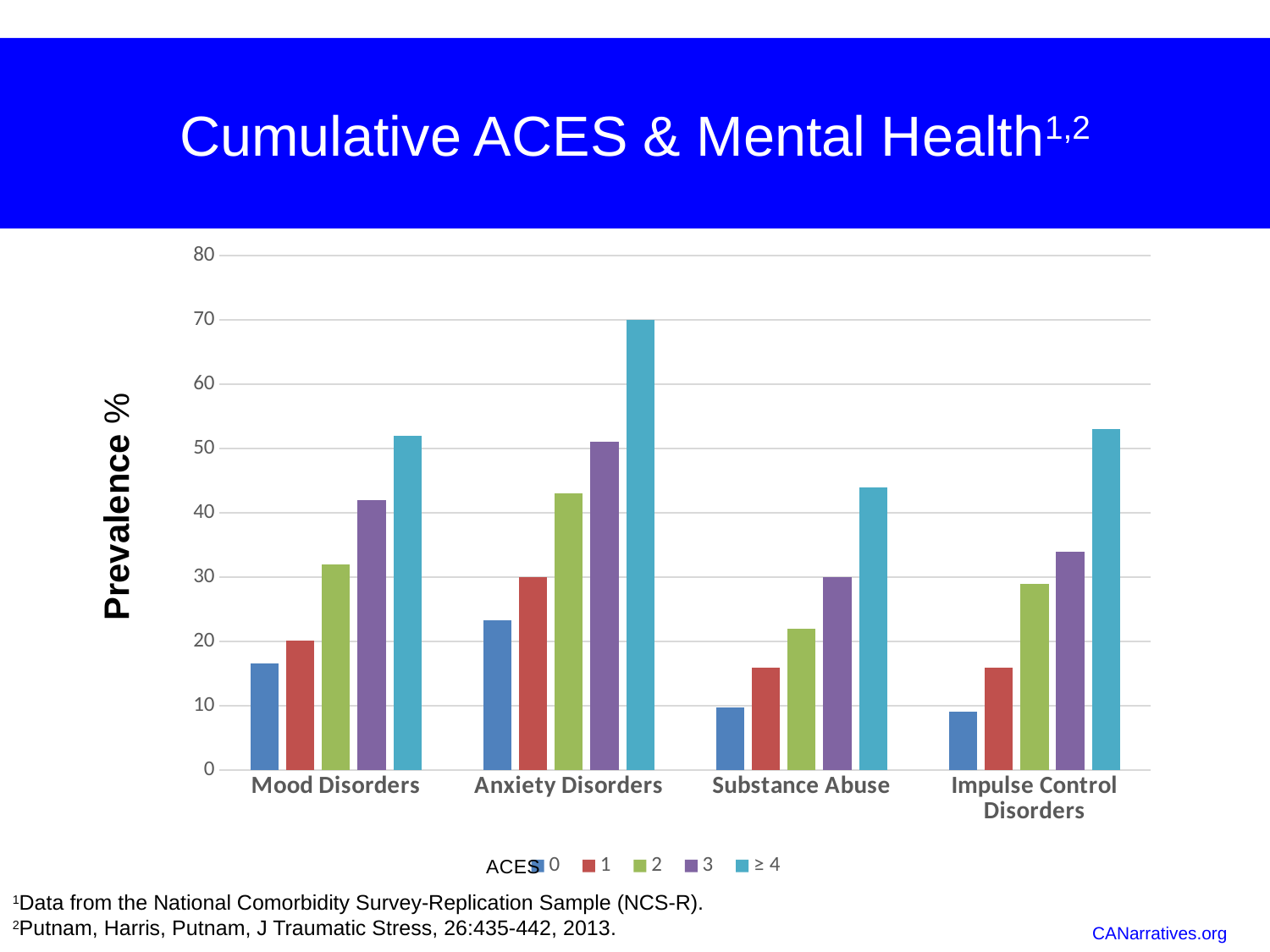
What is the label on the y axis? Prevalence % What is the title of the chart? Cumulative ACES & Mental Health Is the value for ≥ 4 ACES in Substance Abuse greater or less than 40? greater Which category has the highest bar for ≥ 4 ACES? Anxiety Disorders Within the Anxiety Disorders category, do the bars rise or fall as the number of ACES increases? rise What kind of chart is shown on the slide? bar chart How many disorder categories are shown on the x axis? 4 How many series does the legend list? 5 Which category has the lowest bar for ≥ 4 ACES? Substance Abuse Is the value for ≥ 4 ACES in Anxiety Disorders greater or less than 60? greater Which is larger: the value for 3 ACES in Mood Disorders or the value for 3 ACES in Impulse Control Disorders? Mood Disorders Is the value for 0 ACES in Mood Disorders greater or less than 20? less